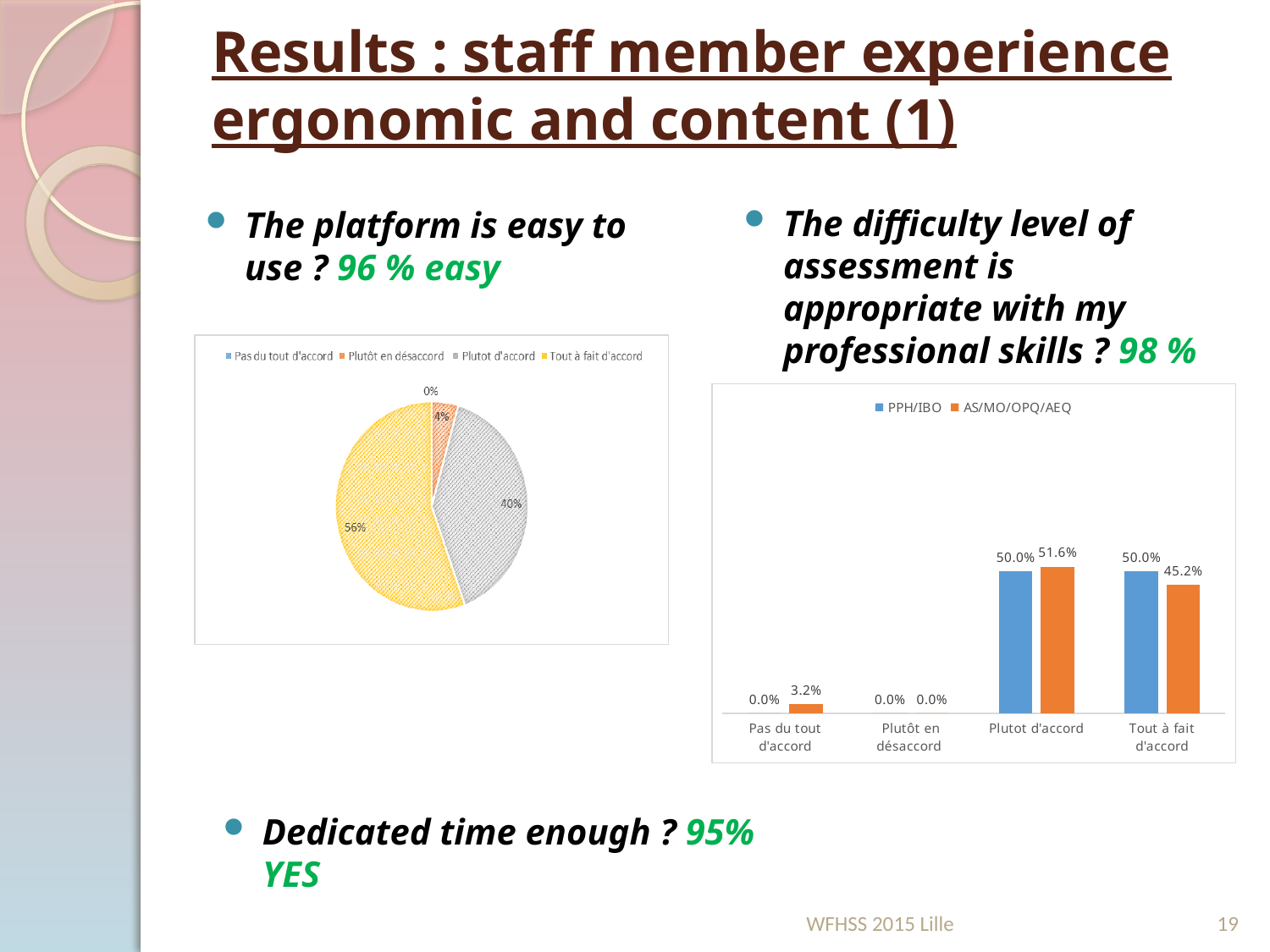
What kind of chart is the chart on the right of the slide? bar chart How many categories does the legend of the pie chart on the left list? 4 In the bar chart on the right, what is the value for AS/MO/OPQ/AEQ in the 'Pas du tout d'accord' category? 3.2% In the bar chart on the right, what is the difference between PPH/IBO and AS/MO/OPQ/AEQ in the 'Tout à fait d'accord' category? 4.8% In the pie chart on the left, what share does 'Plutot d'accord' have? 40% In the pie chart on the left, which category has the largest slice? Tout à fait d'accord In the bar chart on the right, which series has the larger value in the 'Tout à fait d'accord' category? PPH/IBO How many series does the legend of the bar chart on the right list? 2 In the pie chart on the left, what share does 'Tout à fait d'accord' have? 56% In the bar chart on the right, what is the value for AS/MO/OPQ/AEQ in the 'Plutot d'accord' category? 51.6% What kind of chart is the chart on the left of the slide? pie chart In the bar chart on the right, what is the value for PPH/IBO in the 'Tout à fait d'accord' category? 50.0%